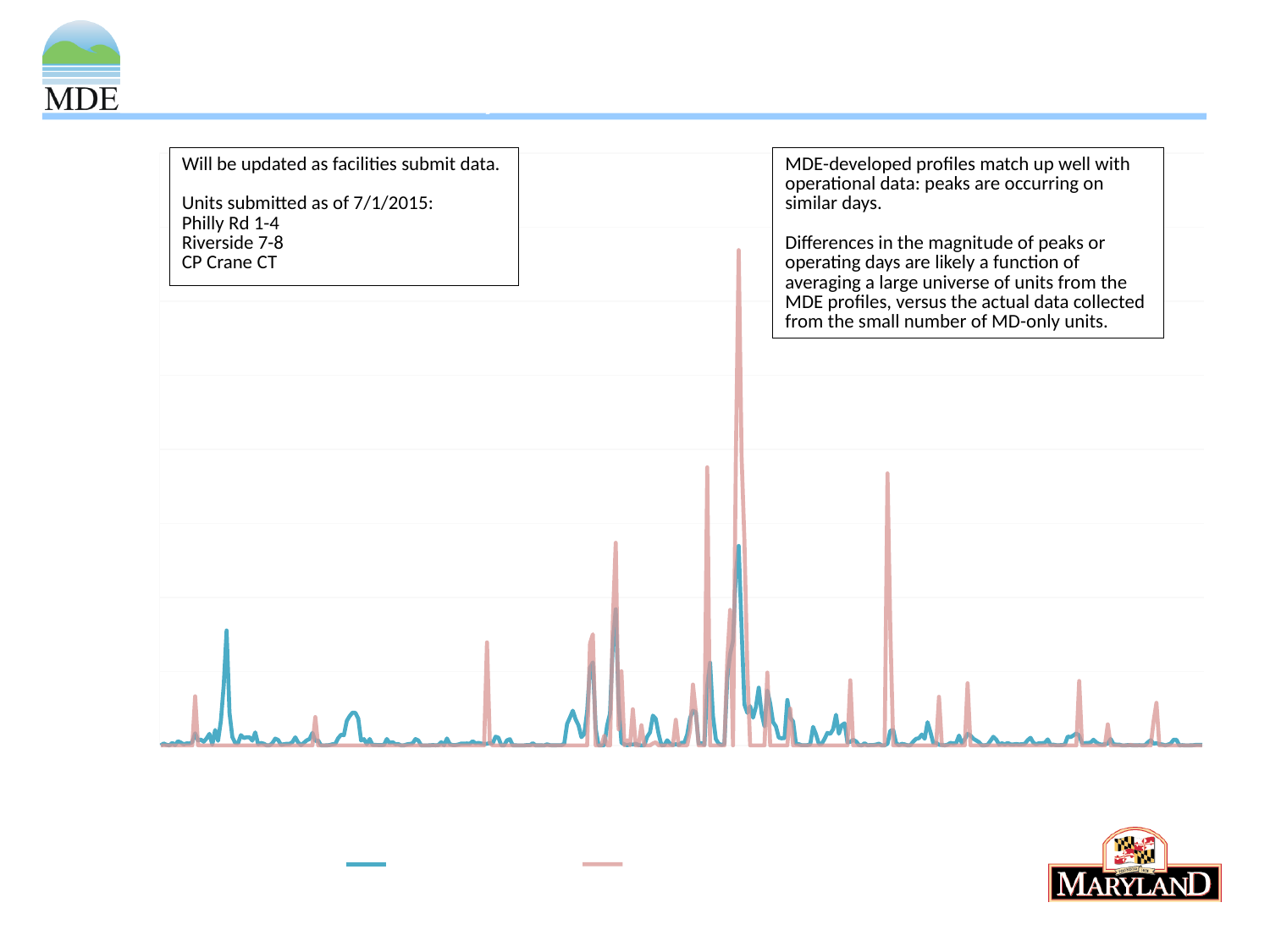
What two colours are used for the lines in the chart? blue and pink What kind of chart is shown on the slide? line chart How many series does the chart's legend list? 2 Which line reaches the highest peak on the chart, the blue line or the pink line? the pink line How many lines are plotted on the chart? 2